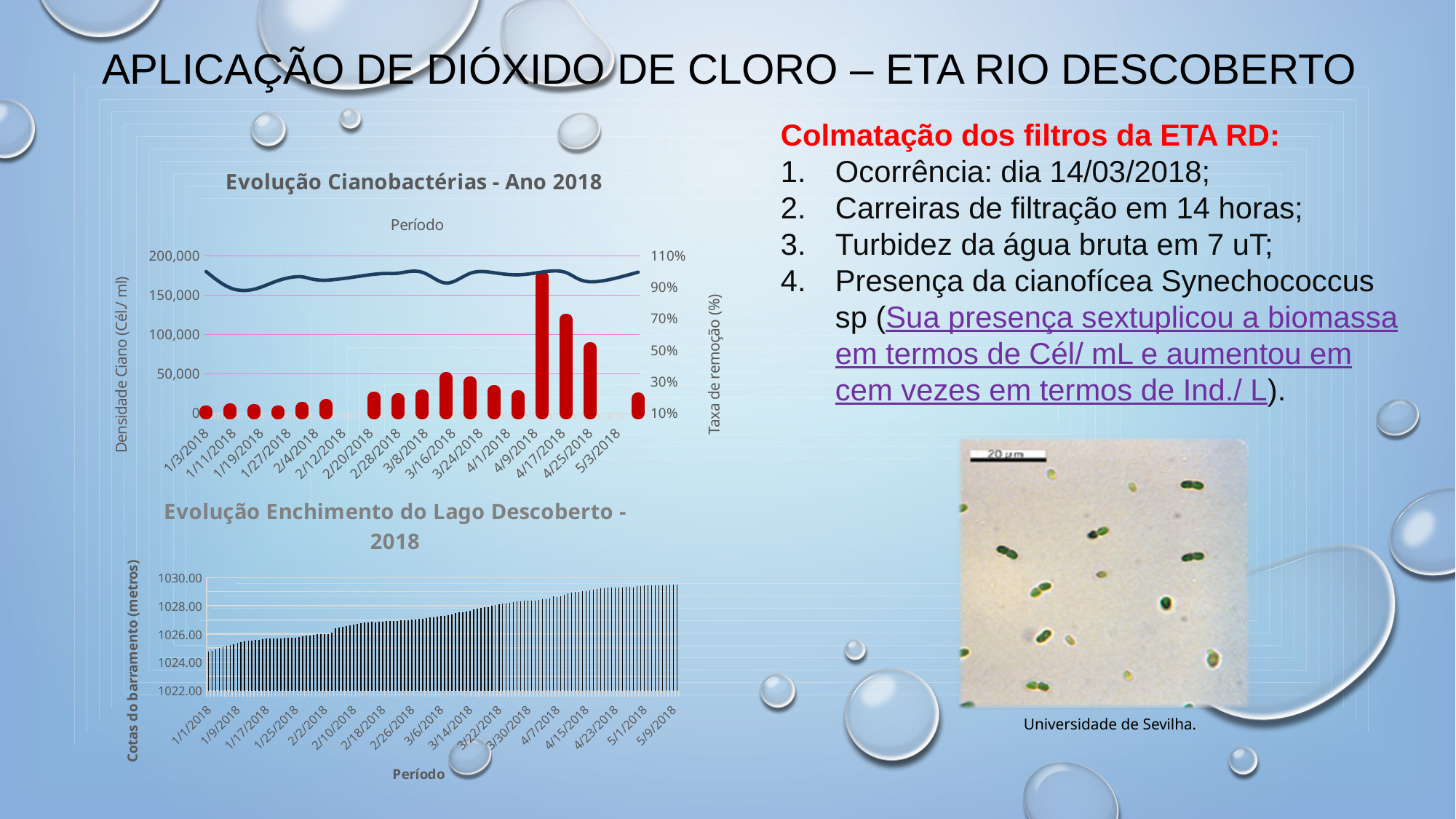
In the chart "Evolução Cianobactérias - Ano 2018", is the bar value for 4/17/2018 greater or less than 100,000? greater In the chart "Evolução Cianobactérias - Ano 2018", is the bar value for 4/25/2018 greater or less than 50,000? greater What is the label of the vertical axis in the chart "Evolução Enchimento do Lago Descoberto - 2018"? Cotas do barramento (metros) In the chart "Evolução Cianobactérias - Ano 2018", is the bar value for 4/9/2018 greater or less than 150,000? greater In the chart "Evolução Cianobactérias - Ano 2018", which date has the tallest red bar? 4/9/2018 What is the label of the left vertical axis in the chart "Evolução Cianobactérias - Ano 2018"? Densidade Ciano (Cél./ ml) In the chart "Evolução Enchimento do Lago Descoberto - 2018", do the values rise or fall along the x axis? rise In the chart "Evolução Cianobactérias - Ano 2018", which bar is larger, 4/9/2018 or 4/17/2018? 4/9/2018 What kind of chart is "Evolução Enchimento do Lago Descoberto - 2018"? bar chart